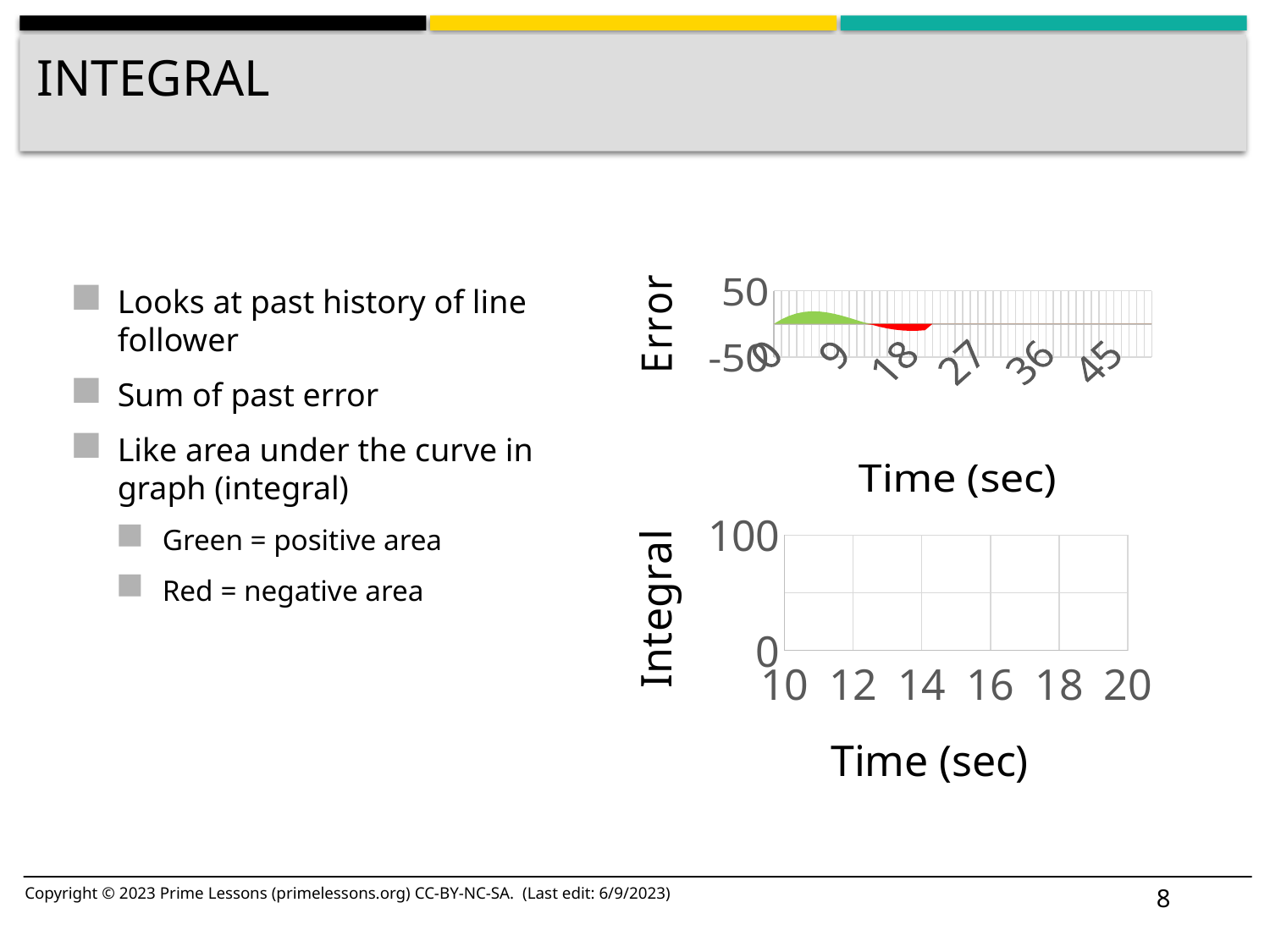
On the top chart, how many tick labels are shown on the horizontal axis? 6 On the top chart, what is the highest value shown on the vertical axis? 50 On the bottom chart, what is the smallest tick value on the Time (sec) axis? 10 On the bottom chart, how many tick labels are shown on the Time (sec) axis? 6 On the bottom chart, what is the highest value shown on the Integral axis? 100 On the top chart, what colour is the area above the zero line? Green On the top chart, what is the largest tick value on the Time (sec) axis? 45 On the top chart, does the error rise or fall between time 9 and time 18? fall On the top chart, is the error at time 9 greater or less than 0? greater On the top chart, what is the label on the vertical axis? Error On the top chart, is the error at time 18 greater or less than 0? less On the top chart, what is the lowest value shown on the vertical axis? -50